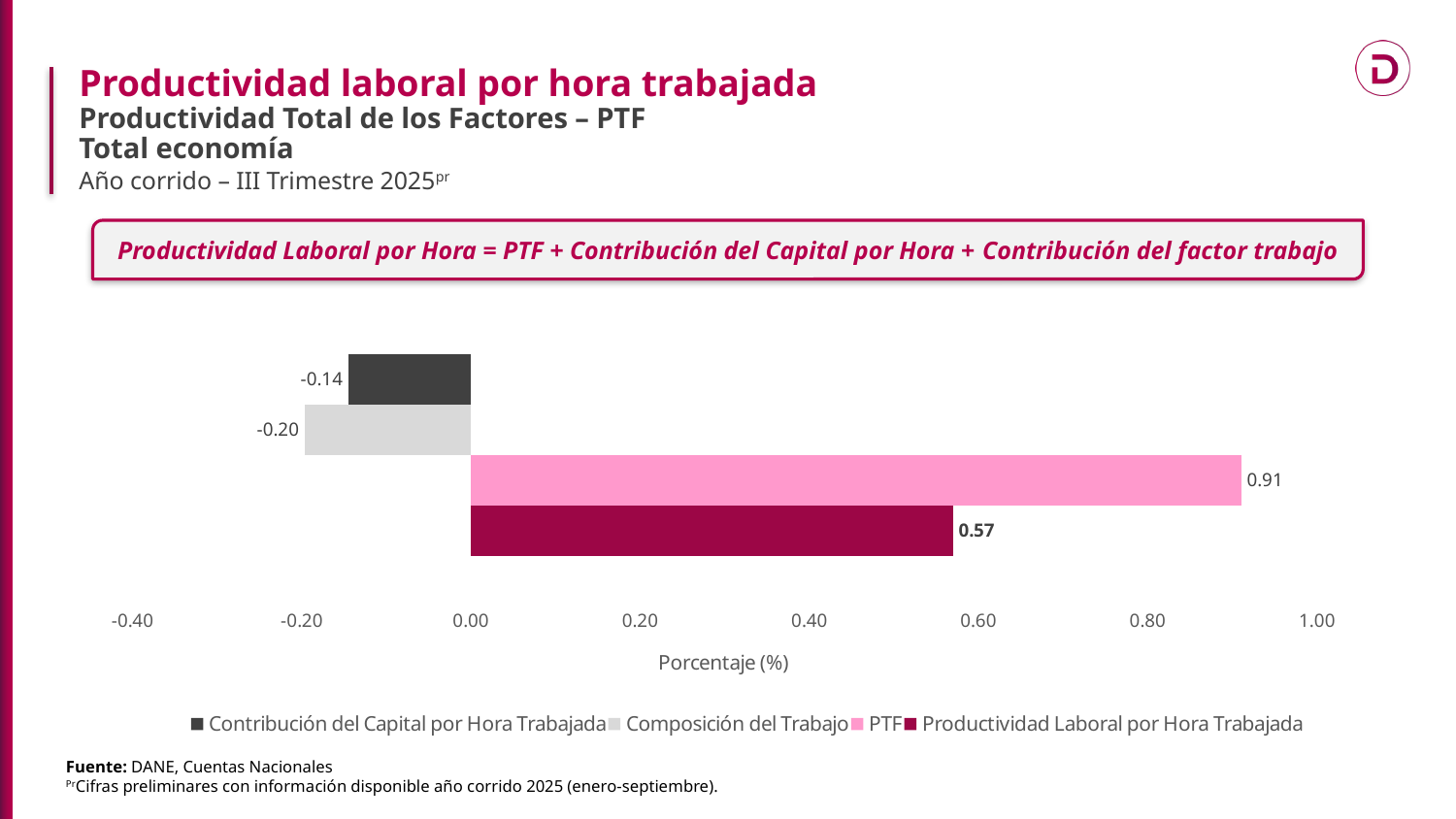
What is the value for Productividad Laboral por Hora Trabajada? 0.57 Which is larger, the value for Contribución del Capital por Hora Trabajada or the value for Composición del Trabajo? Contribución del Capital por Hora Trabajada What is the value for PTF? 0.91 Which series has the lowest value? Composición del Trabajo What is the value for Composición del Trabajo? -0.20 Which series has the highest value? PTF Is the value for PTF greater or less than 0.80? greater How many series does the legend list? 4 What is the label of the horizontal axis? Porcentaje (%) What is the difference between the PTF value and the Productividad Laboral por Hora Trabajada value? 0.34 What is the value for Contribución del Capital por Hora Trabajada? -0.14 What kind of chart is shown on the slide? Bar chart